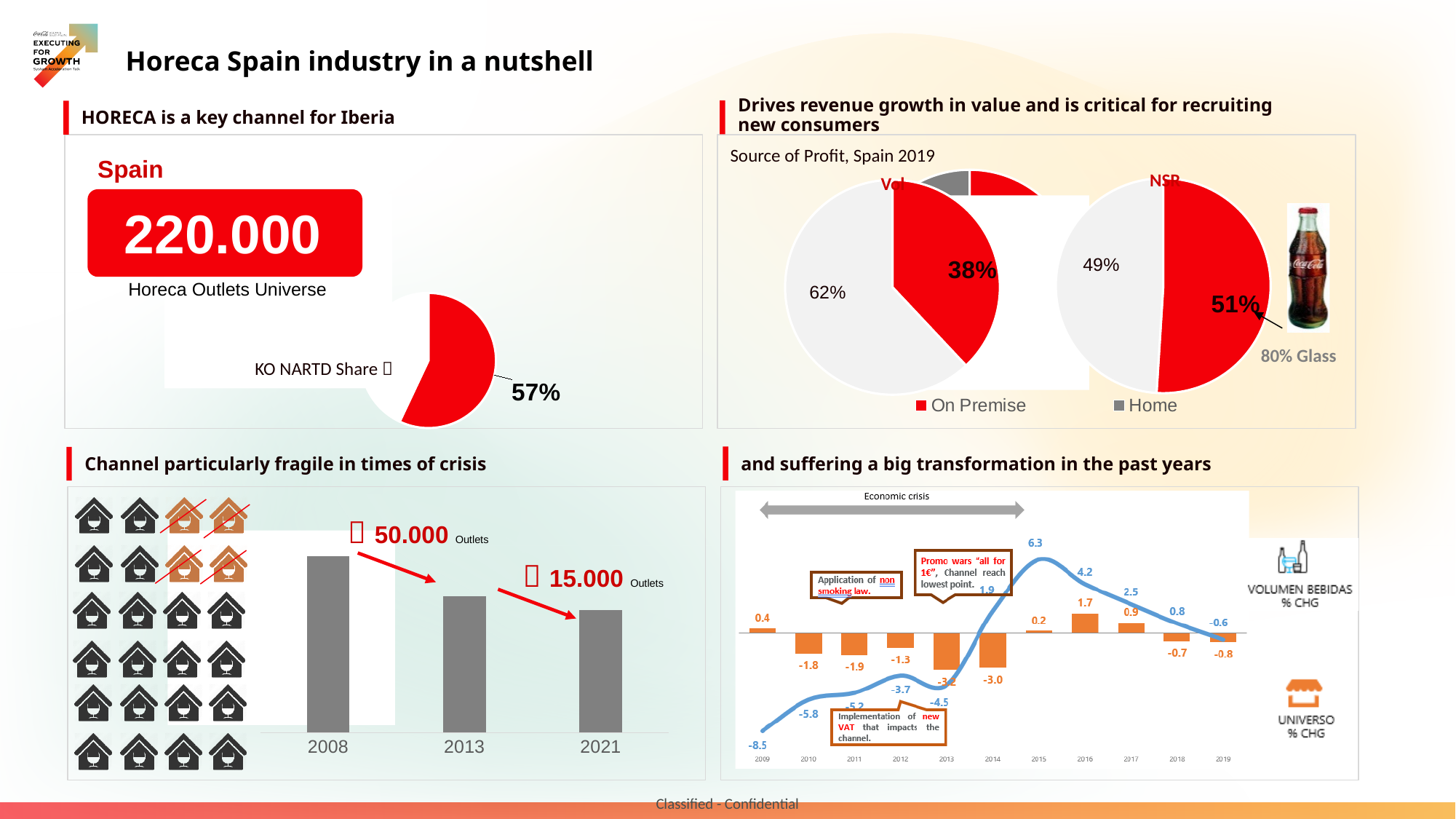
In the bottom-right chart, what is the UNIVERSO % CHG value for 2013? -3.2 How many bars are in the bottom-left bar chart with years 2008, 2013 and 2021? 3 In the Source of Profit, Spain 2019 NSR pie chart, what share does Home have? 49% How many series does the legend of the Source of Profit, Spain 2019 charts list? 2 In the bottom-left bar chart with years 2008, 2013 and 2021, do the bars rise or fall from 2008 to 2021? fall In the KO NARTD Share pie chart on the left, what value is shown for the red slice? 57% In the bottom-right chart, which year has the lowest VOLUMEN BEBIDAS % CHG value? 2009 In the Source of Profit, Spain 2019 Vol pie chart, what share does On Premise have? 38% In the bottom-left bar chart with years 2008, 2013 and 2021, which year has the highest bar? 2008 In the bottom-right chart, what is the VOLUMEN BEBIDAS % CHG value for 2015? 6.3 In the bottom-right chart, what is the difference between the UNIVERSO % CHG values for 2016 and 2017? 0.8 In the Source of Profit, Spain 2019 Vol pie chart, which segment is larger, On Premise or Home? Home